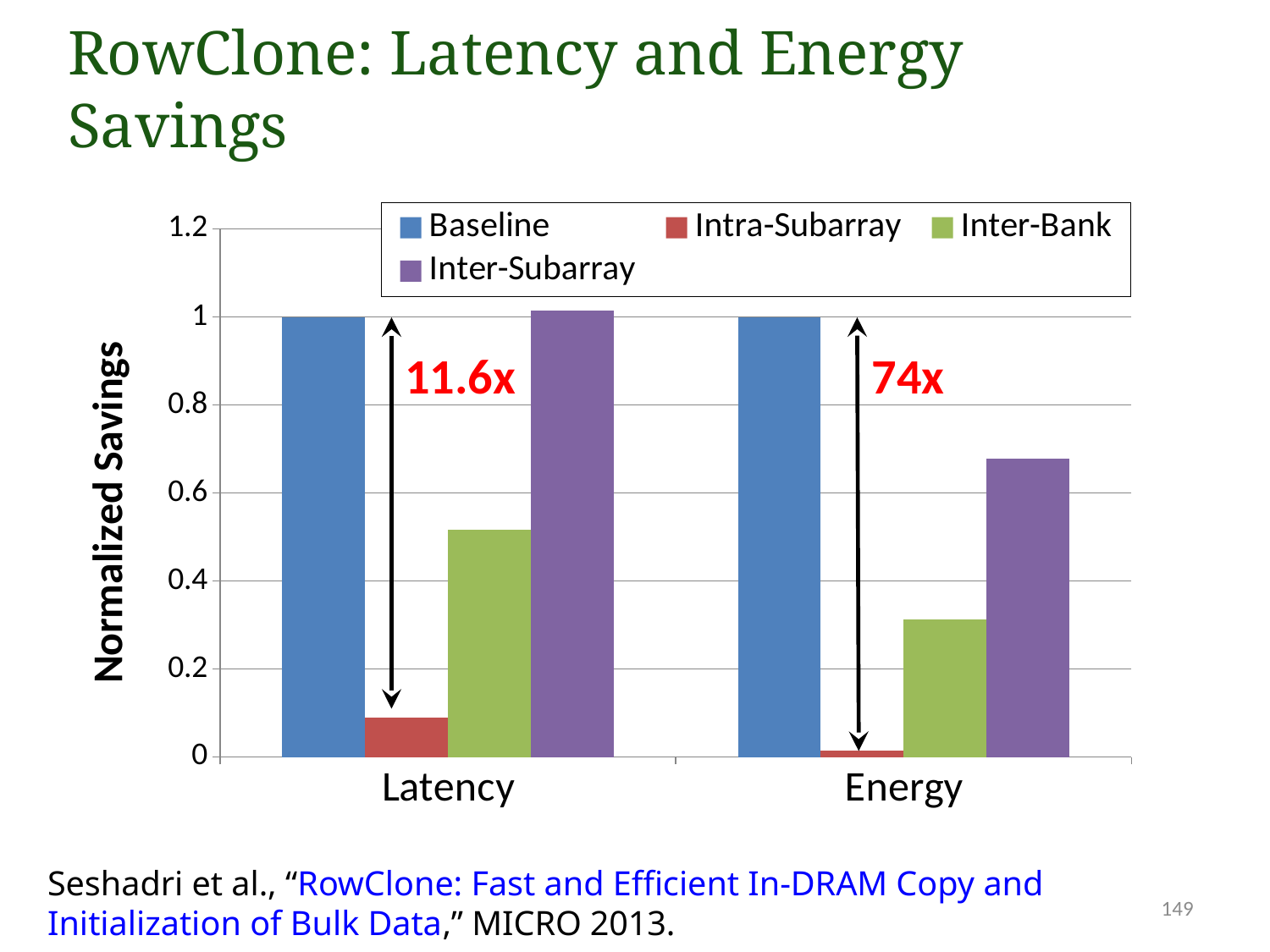
What is the Baseline value for Latency? 1 How many series does the legend list? 4 What is the Baseline value for Energy? 1 For Latency, which is larger: Inter-Bank or Inter-Subarray? Inter-Subarray What is the title of the y axis? Normalized Savings Is the Intra-Subarray value for Latency greater or less than 0.2? less Which series has the lowest value for Energy? Intra-Subarray How many categories are shown on the x axis? 2 Is the Inter-Bank value for Energy greater or less than 0.4? less Is the Inter-Subarray value for Energy greater or less than 0.6? greater What kind of chart is shown on the slide? bar chart